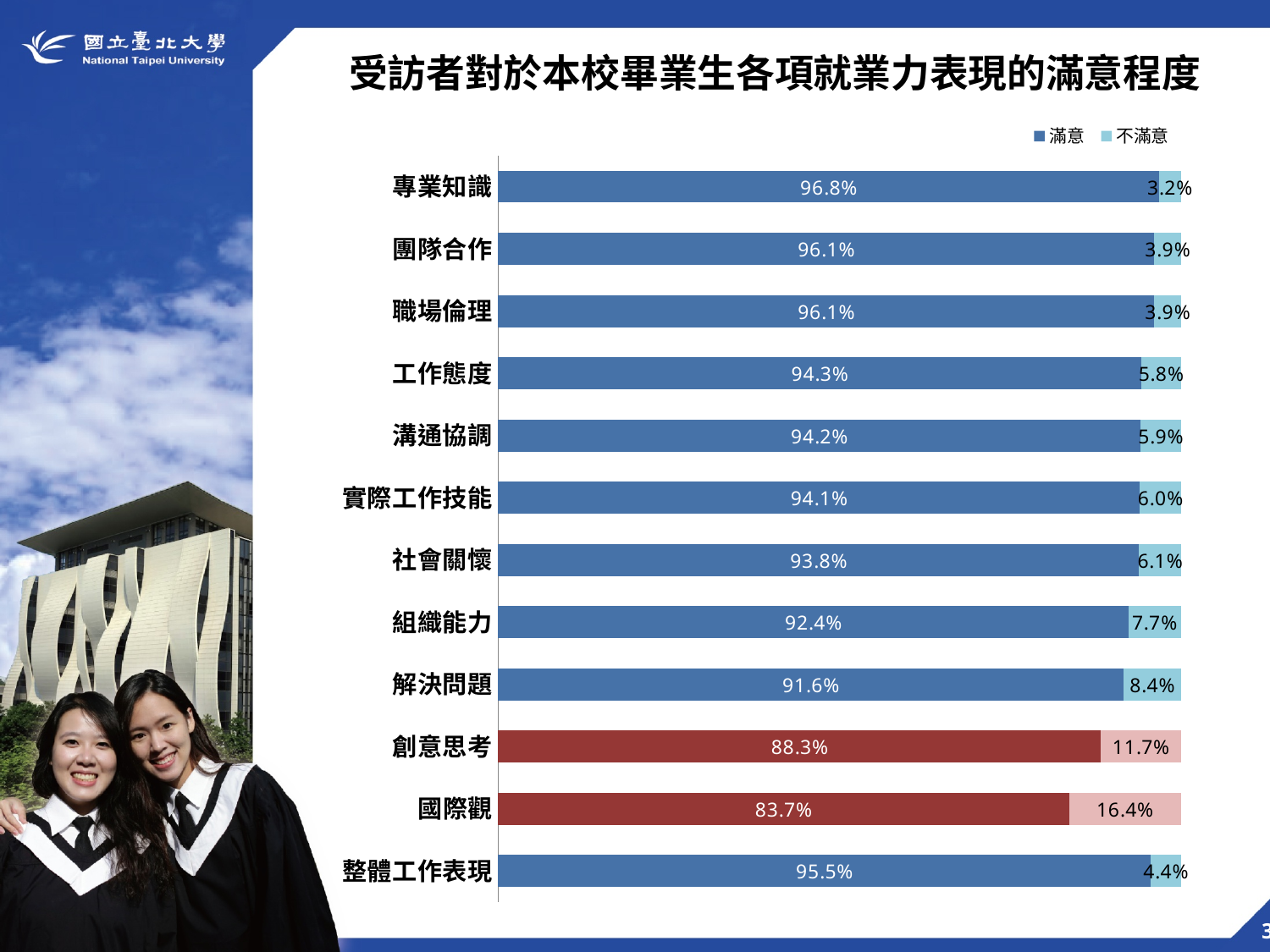
Which has a larger 不滿意 value, 創意思考 or 解決問題? 創意思考 Which category has the highest 不滿意 value? 國際觀 Which category has the highest 滿意 value? 專業知識 Which two categories are drawn in red instead of blue? 創意思考 and 國際觀 How many series does the legend list? 2 How many categories are plotted in the chart? 12 What is the 滿意 value for 專業知識? 96.8% What type of chart is shown on the slide? Stacked bar chart Which category has the lowest 滿意 value? 國際觀 What is the difference between the 滿意 values for 專業知識 and 國際觀? 13.1 percentage points What is the 滿意 value for 整體工作表現? 95.5% What is the 不滿意 value for 國際觀? 16.4%